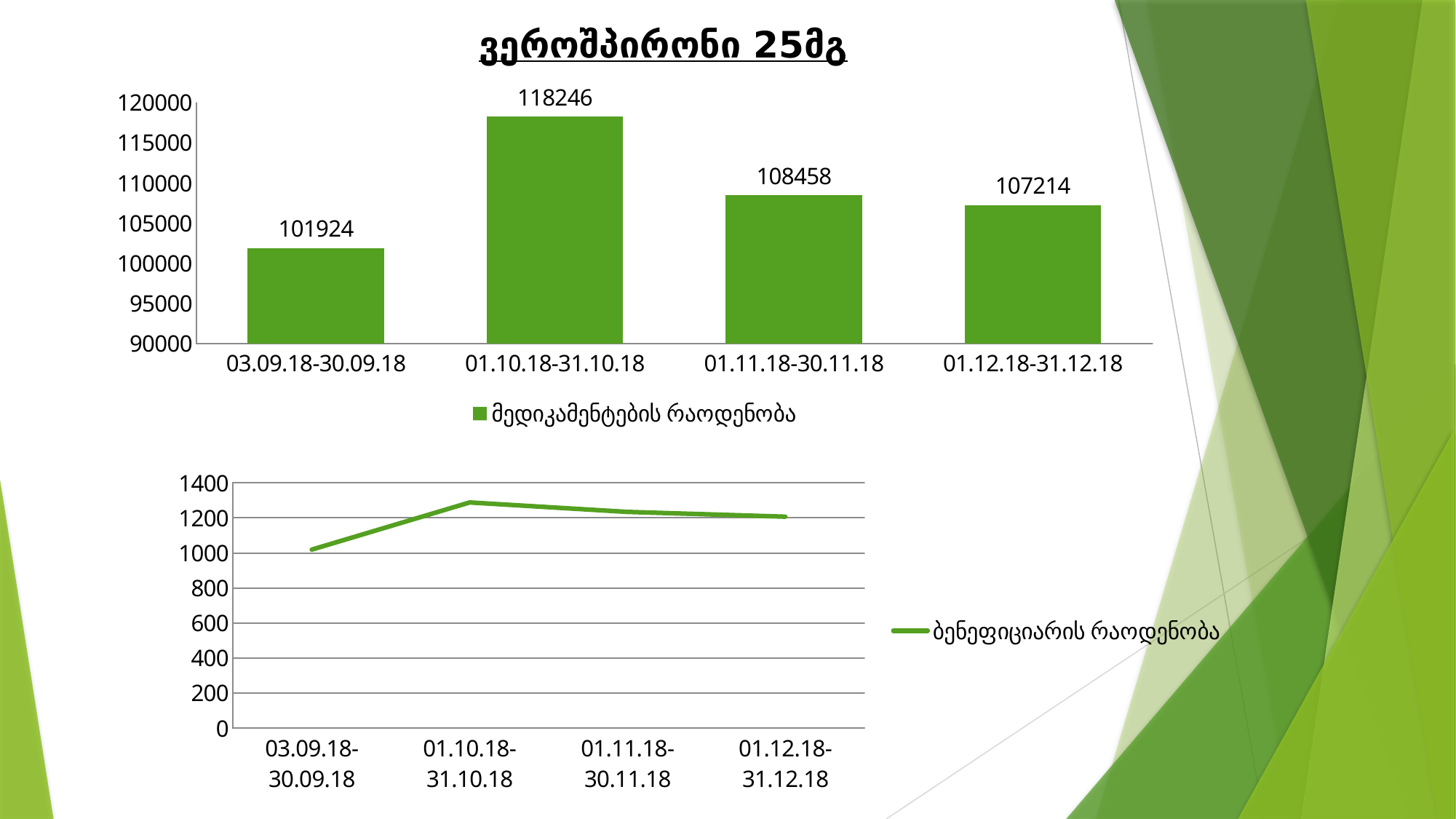
In the bottom line chart, is the value for 01.10.18-31.10.18 greater or less than 1200? greater What kind of chart is the bottom chart on the slide? line chart In the top bar chart, which period has the highest value? 01.10.18-31.10.18 In the bottom line chart, is the value for 03.09.18-30.09.18 greater or less than 1200? less In the top bar chart, what is the value for 01.10.18-31.10.18? 118246 How many bars are in the top bar chart? 4 In the top bar chart, what is the value for 03.09.18-30.09.18? 101924 What is the title of the top bar chart? ვეროშპირონი 25მგ In the top bar chart, which period has the lowest value? 03.09.18-30.09.18 In the top bar chart, what is the difference between the values for 01.10.18-31.10.18 and 01.11.18-30.11.18? 9788 In the top bar chart, which is larger: the value for 01.11.18-30.11.18 or for 01.12.18-31.12.18? 01.11.18-30.11.18 In the top bar chart, what is the value for 01.12.18-31.12.18? 107214